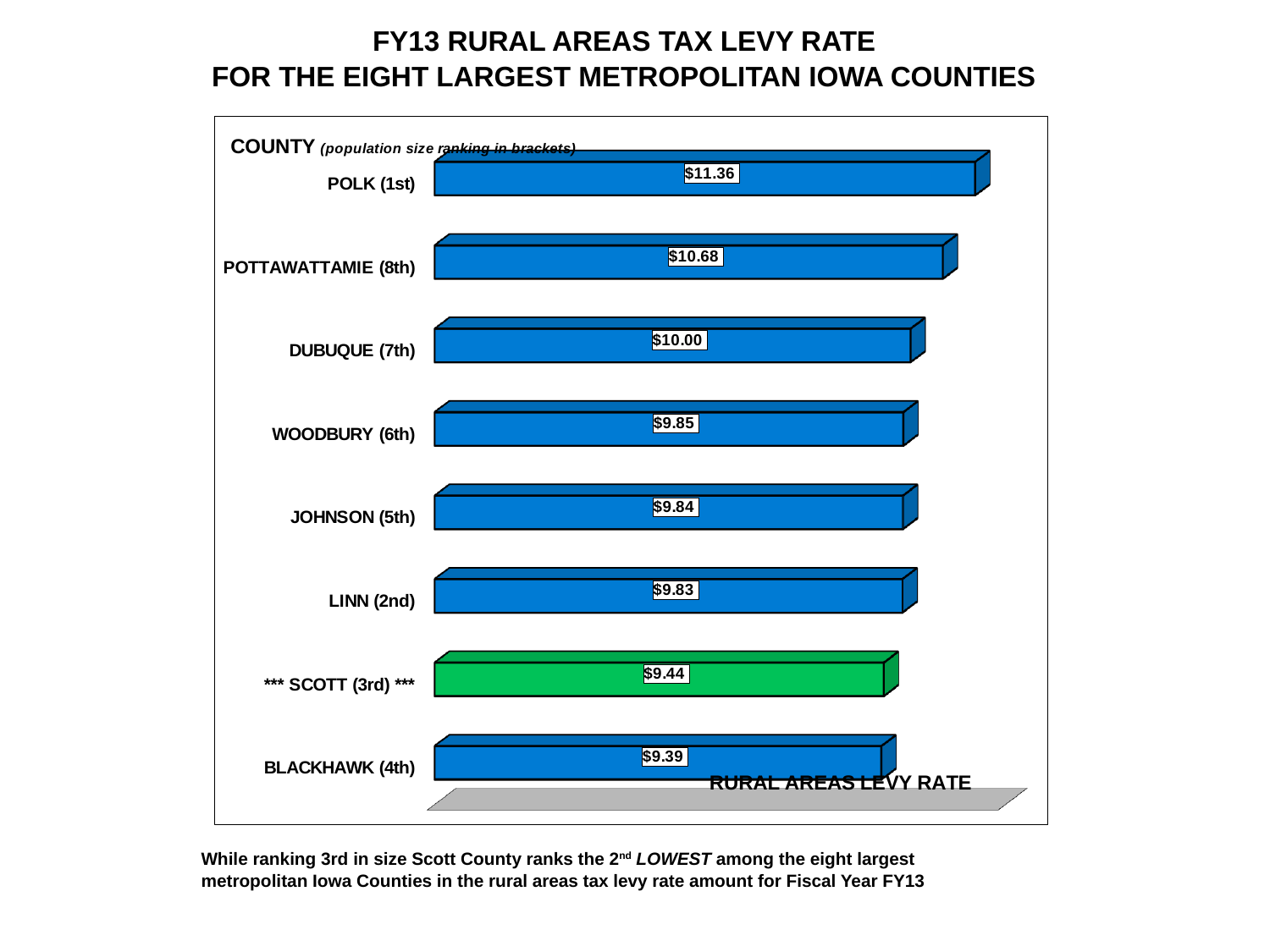
What kind of chart is shown on the slide? bar chart What is the difference between the levy rates of POLK (1st) and BLACKHAWK (4th)? $1.97 What is the difference between the levy rates of POTTAWATTAMIE (8th) and *** SCOTT (3rd) ***? $1.24 What is the rural areas levy rate for POLK (1st)? $11.36 Which county's bar is coloured green rather than blue? *** SCOTT (3rd) *** Which has a higher rural areas levy rate, POTTAWATTAMIE (8th) or WOODBURY (6th)? POTTAWATTAMIE (8th) Which county has the highest rural areas levy rate? POLK (1st) What is the rural areas levy rate for *** SCOTT (3rd) ***? $9.44 Which county has the lowest rural areas levy rate? BLACKHAWK (4th) What is the rural areas levy rate for DUBUQUE (7th)? $10.00 What is the title of the chart? FY13 RURAL AREAS TAX LEVY RATE FOR THE EIGHT LARGEST METROPOLITAN IOWA COUNTIES How many counties are shown in the chart? 8